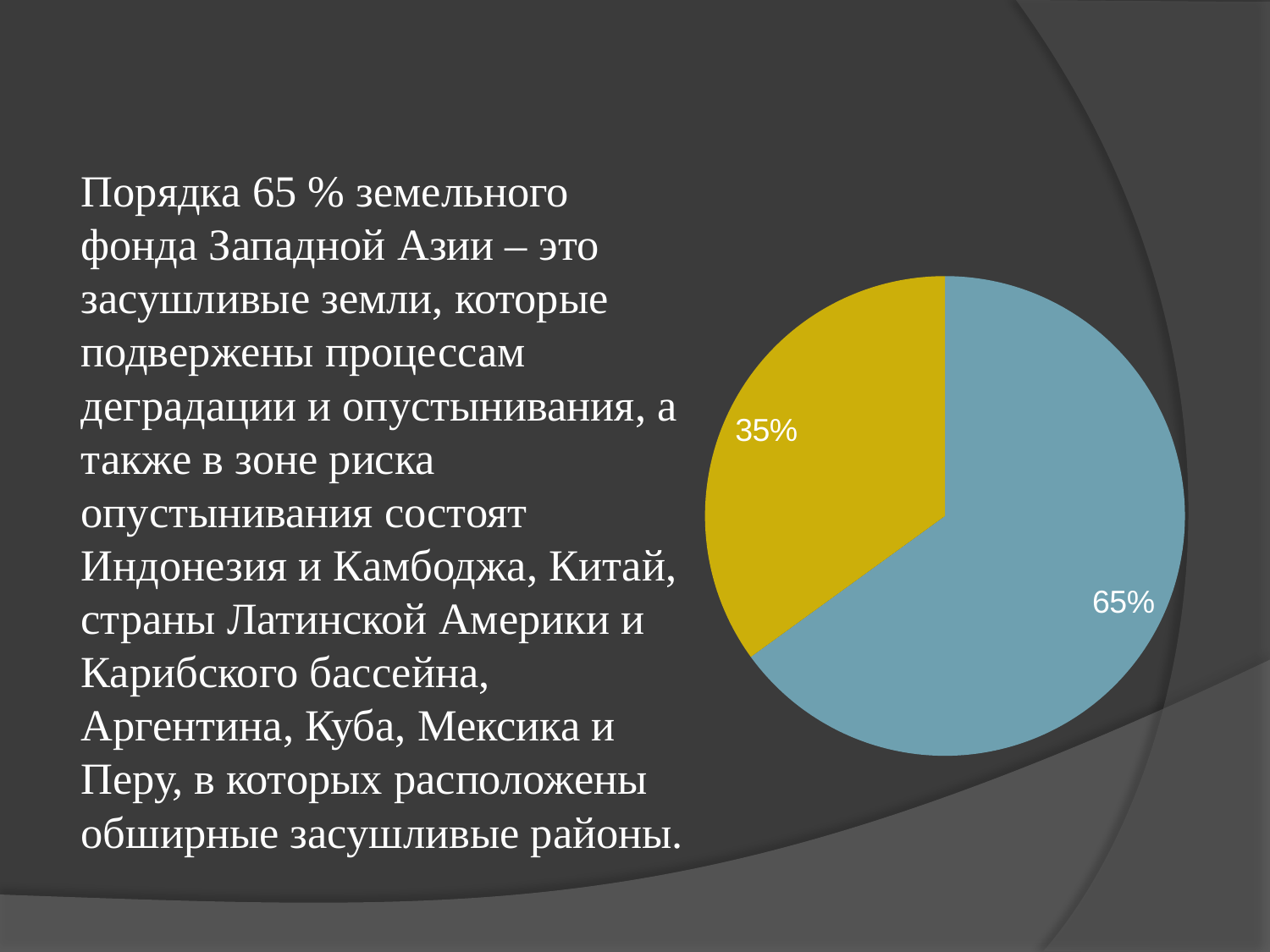
What is the difference in percentage points between the blue slice and the yellow slice? 30 Which slice of the pie chart is the largest? the blue slice (65%) Which is larger in the pie chart, the blue slice or the yellow slice? the blue slice What kind of chart is shown on the slide? pie chart What colour is the slice labelled 35%? yellow Which slice of the pie chart is the smallest? the yellow slice (35%) Is the value of the blue slice greater or less than 50%? greater What share of the pie does the yellow slice represent? 35% What percentage is shown on the blue slice of the pie chart? 65% What percentage is shown on the yellow slice of the pie chart? 35% How many slices does the pie chart have? 2 Does the pie chart have a legend? No